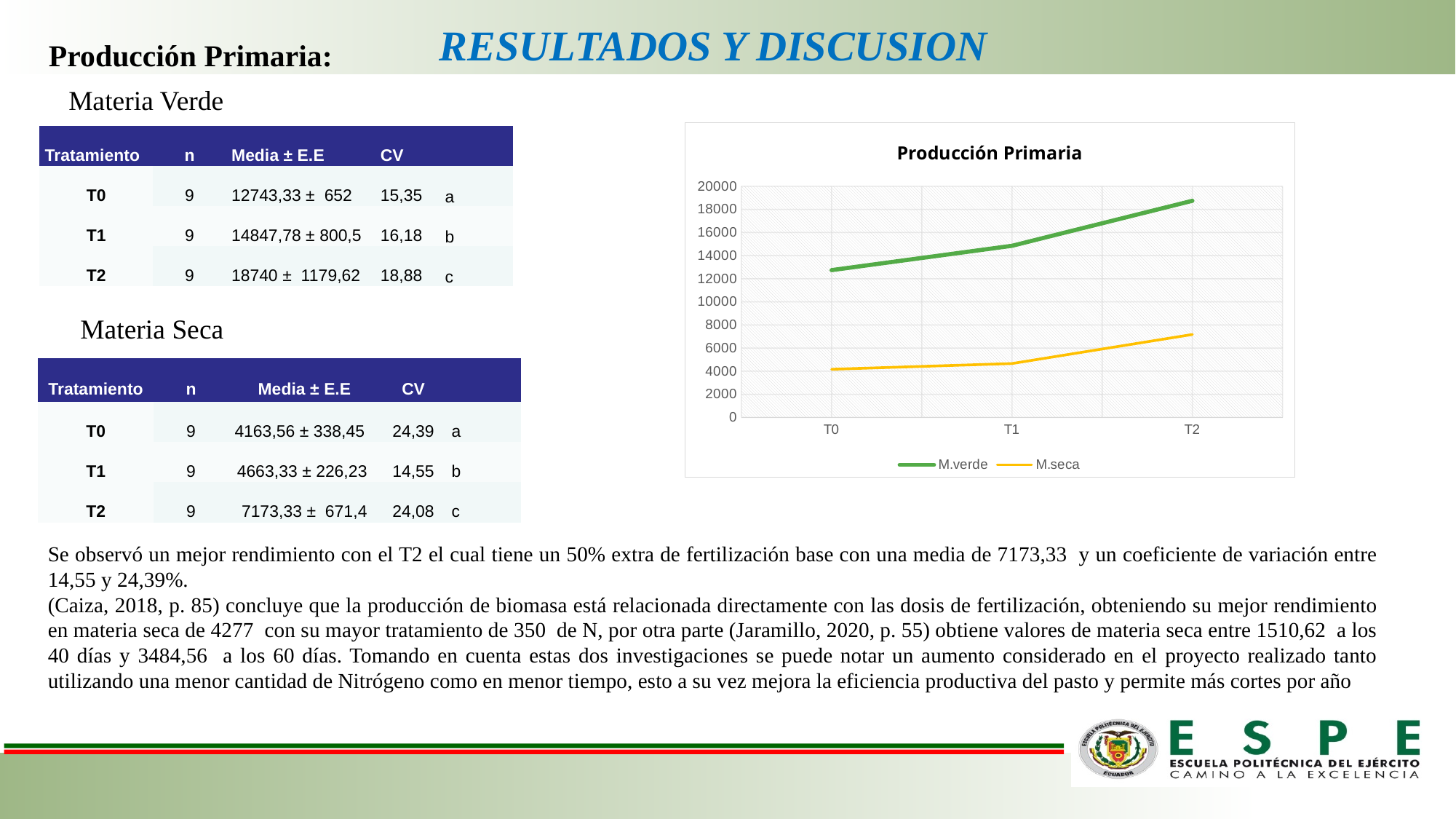
Is the value for M.seca at T1 greater or less than 6000? less What kind of chart is shown on the slide? line chart Is the value for M.verde at T0 greater or less than 12000? greater At which category is the M.seca series lowest? T0 How many categories are shown on the x axis of the chart? 3 What is the title of the chart? Producción Primaria At T2, which series has the larger value, M.verde or M.seca? M.verde How many series does the chart legend list? 2 Is the value for M.verde at T2 greater or less than 18000? greater Do the values of the M.verde series rise or fall from T0 to T2? rise At which category does the M.verde series reach its highest value? T2 Which series is drawn in green in the chart? M.verde